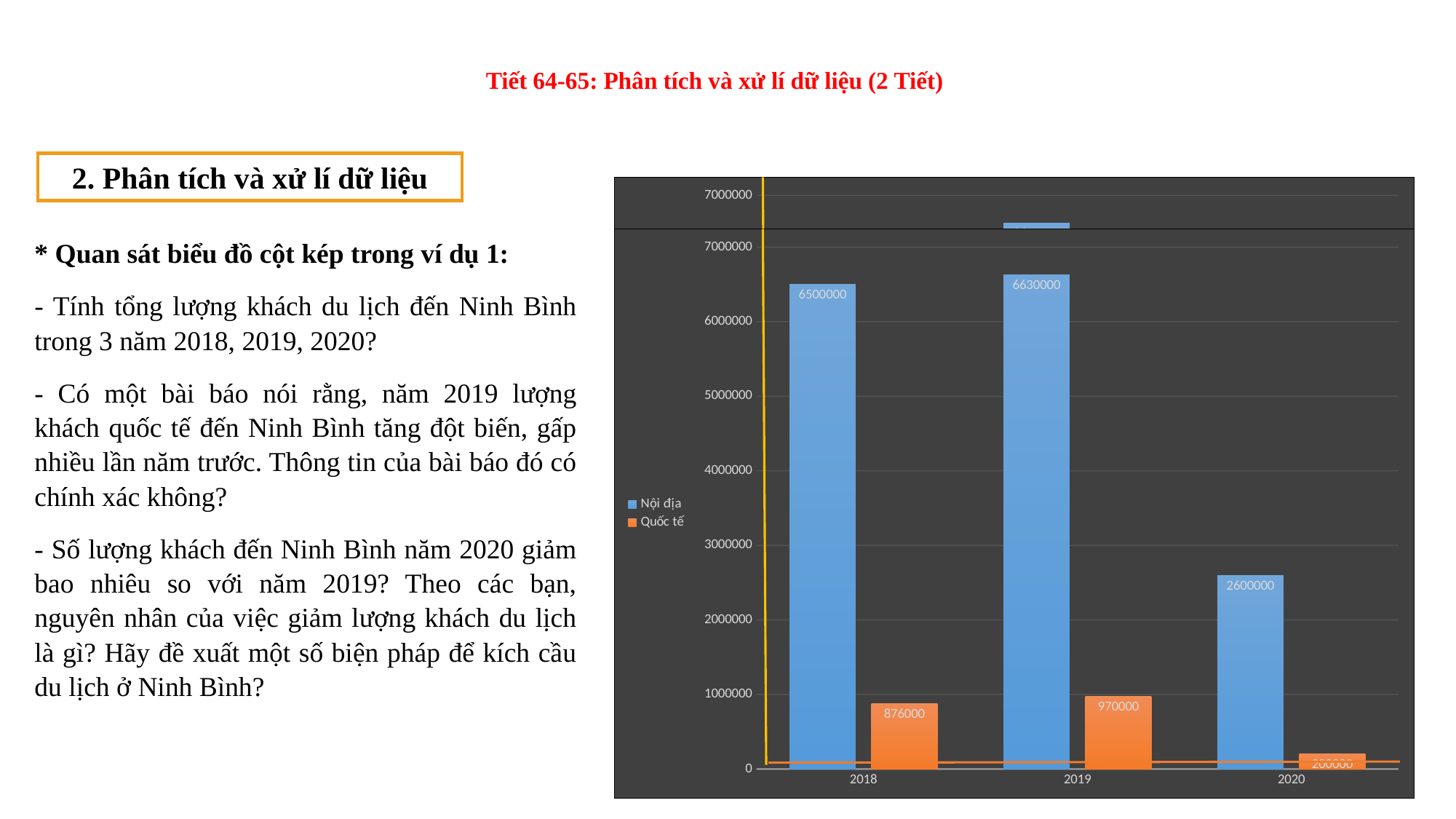
What is the value of Nội địa for 2019? 6630000 In which year is the Nội địa value lowest? 2020 What is the value of Nội địa for 2020? 2600000 What is the value of Quốc tế for 2018? 876000 What is the value of Nội địa for 2018? 6500000 By how much did the Nội địa value fall from 2019 to 2020? 4030000 In which year is the Nội địa value highest? 2019 What is the value of Quốc tế for 2019? 970000 Which year has the larger Quốc tế value, 2018 or 2019? 2019 What kind of chart is shown on the slide? bar chart How many series does the legend list? 2 Is the Quốc tế value for 2020 greater or less than 1000000? less